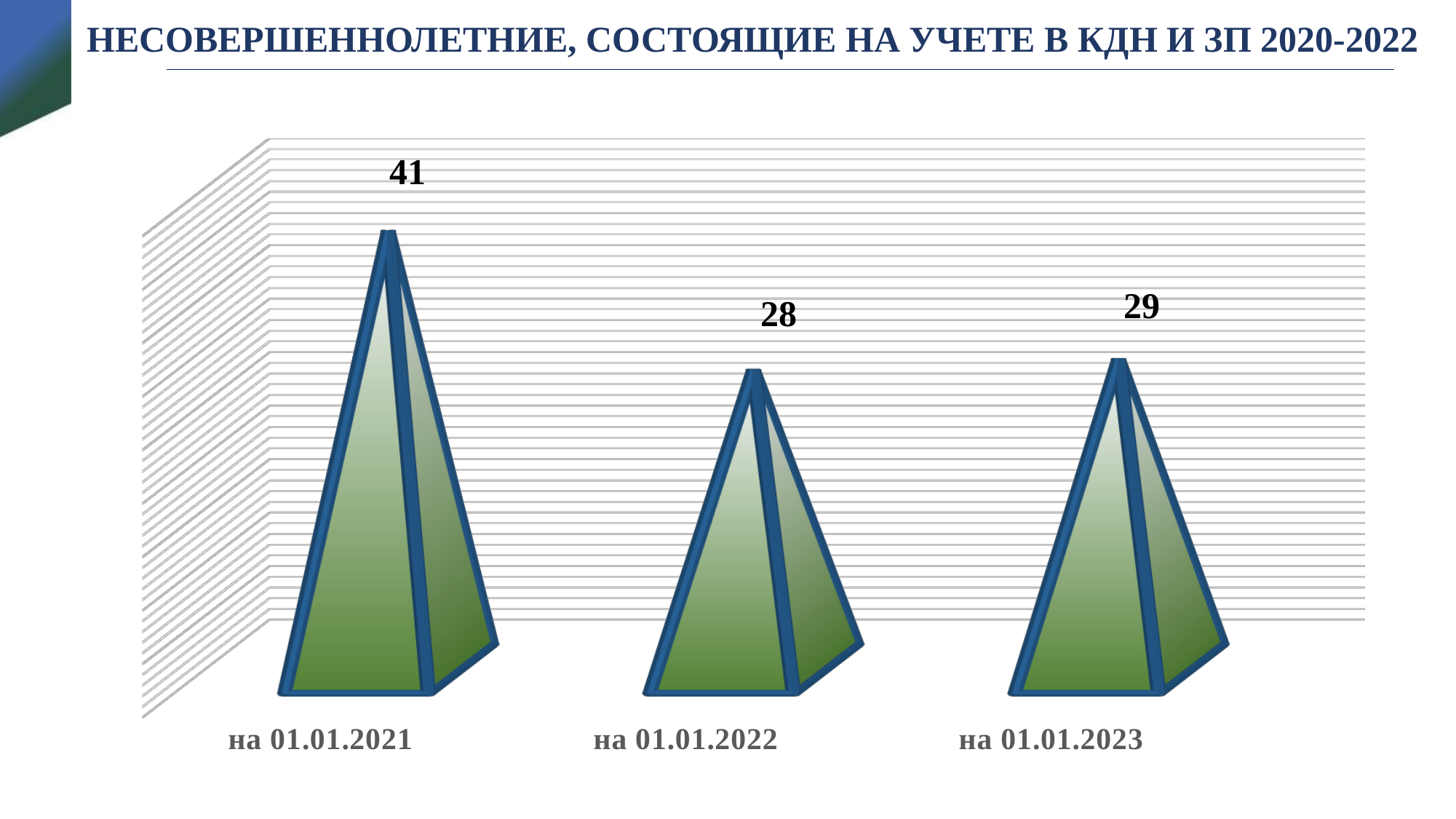
How many categories are shown on the chart? 3 What is the value for на 01.01.2021? 41 Which category has the highest value? на 01.01.2021 Which category has the lowest value? на 01.01.2022 Which is larger, the value for на 01.01.2021 or the value for на 01.01.2023? на 01.01.2021 What is the title of the chart? НЕСОВЕРШЕННОЛЕТНИЕ, СОСТОЯЩИЕ НА УЧЕТЕ В КДН И ЗП 2020-2022 What is the value for на 01.01.2022? 28 What is the value for на 01.01.2023? 29 What is the difference between the values for на 01.01.2023 and на 01.01.2022? 1 What is the difference between the values for на 01.01.2021 and на 01.01.2022? 13 What kind of chart is shown on the slide? bar chart Do the values rise or fall from на 01.01.2021 to на 01.01.2022? fall